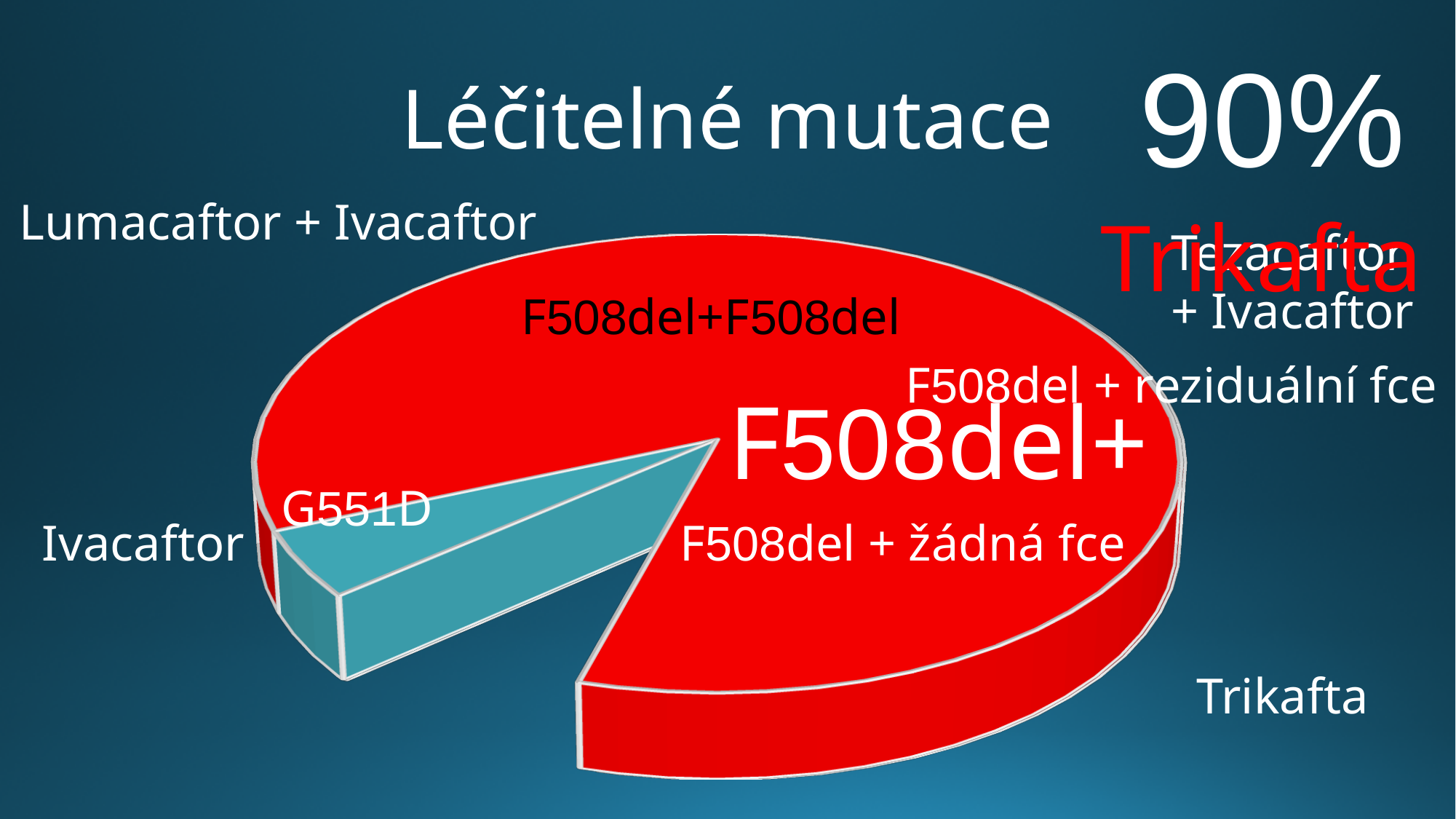
What is the title of the chart on the slide? Léčitelné mutace Which slice of the pie chart is the largest? F508del+ Which slice is pulled out (exploded) from the pie chart? G551D Which is larger in the pie chart, the F508del+ slice or the G551D slice? F508del+ What kind of chart is shown on the slide? pie chart What colour is the G551D slice in the pie chart? teal